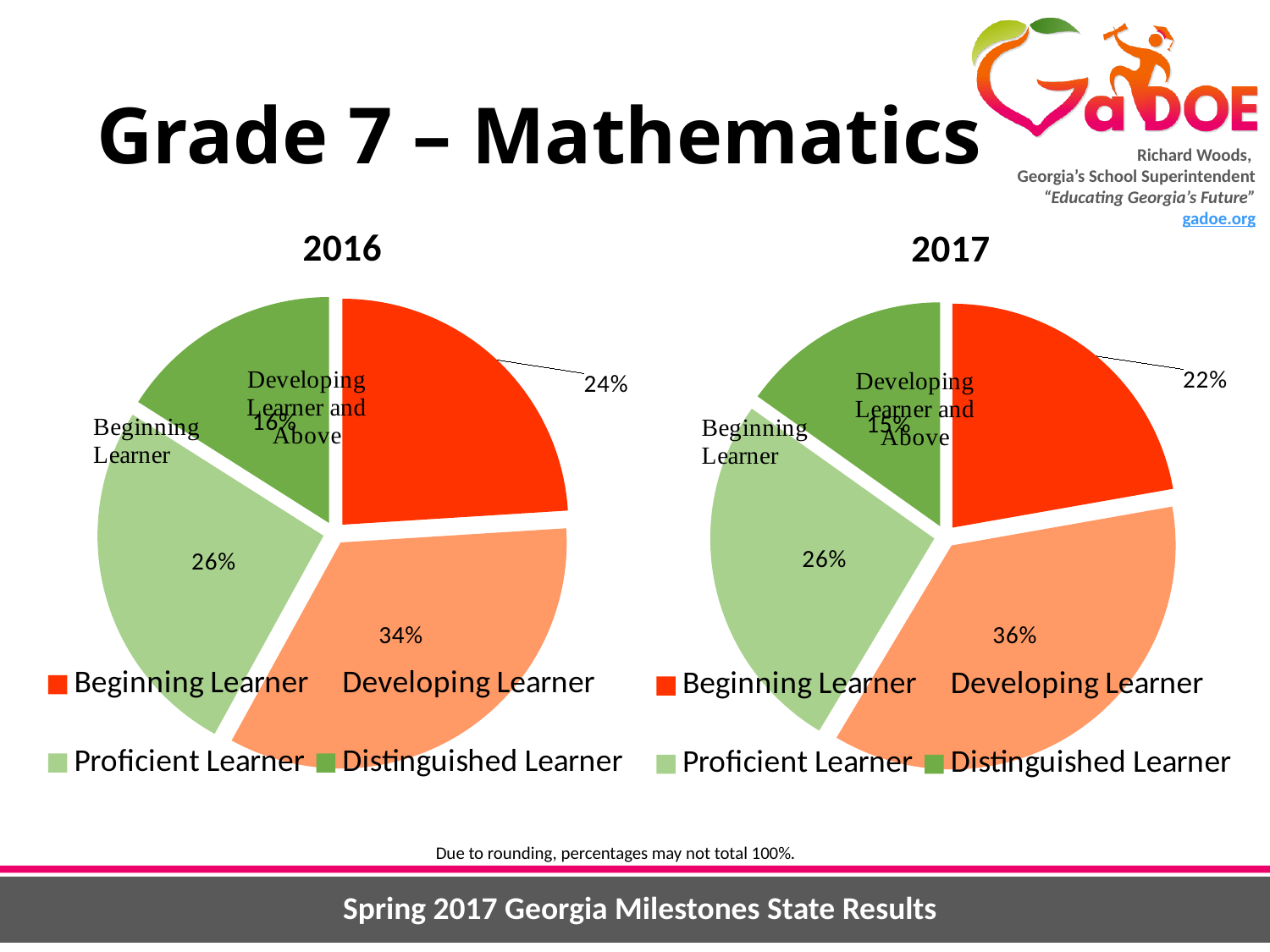
In the 2017 pie chart, what percentage is shown for Developing Learner? 36% How many slices does the 2017 pie chart have? 4 Which is larger: Beginning Learner in the 2016 pie chart or Beginning Learner in the 2017 pie chart? 2016 In the 2017 pie chart, which category has the smallest slice? Distinguished Learner In the 2016 pie chart, what percentage is shown for Proficient Learner? 26% In the 2016 pie chart, what percentage is shown for Beginning Learner? 24% What is the difference between the Developing Learner percentages in the 2017 and 2016 pie charts? 2% What type of chart is used for the 2016 results? Pie chart In the 2016 pie chart, which category has the largest slice? Developing Learner How many entries does the legend of the 2016 chart list? 4 In the 2017 pie chart, what percentage is shown for Beginning Learner? 22% In the 2016 pie chart, what is the difference between the Developing Learner and Beginning Learner percentages? 10%